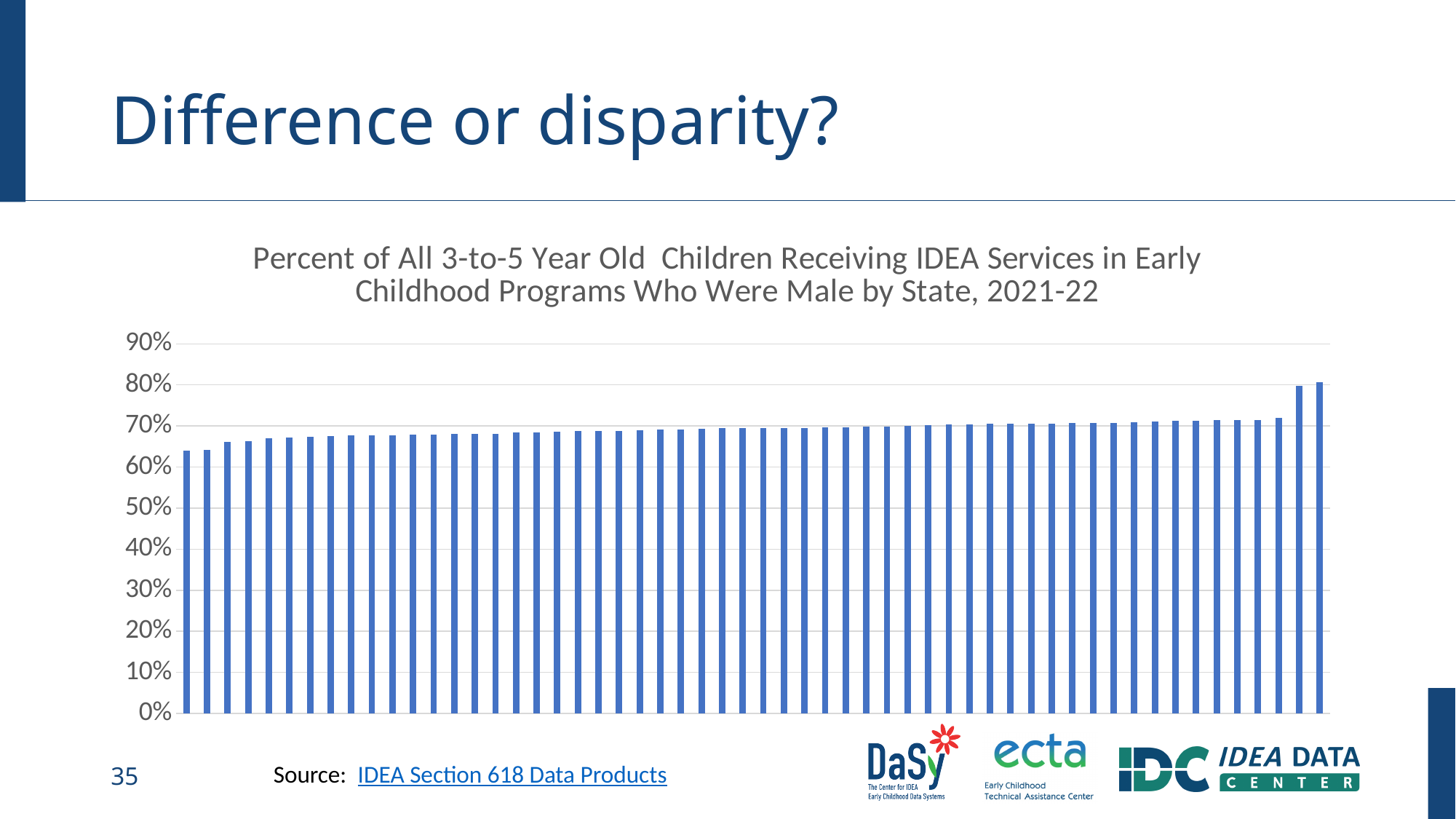
Is the value of the leftmost bar greater or less than 70%? less Is the value of the rightmost bar greater or less than 90%? less Is the value of the rightmost bar greater or less than 70%? greater Is the rightmost bar larger or smaller than the leftmost bar? Larger What is the highest value shown on the vertical axis? 90% What kind of chart is shown on the slide? Bar chart Which bar is the shortest in the chart: the leftmost or the rightmost? The leftmost Do the bar values rise or fall from left to right across the chart? Rise What is the title of the chart? Percent of All 3-to-5 Year Old Children Receiving IDEA Services in Early Childhood Programs Who Were Male by State, 2021-22 Which bar is the tallest in the chart: the leftmost or the rightmost? The rightmost